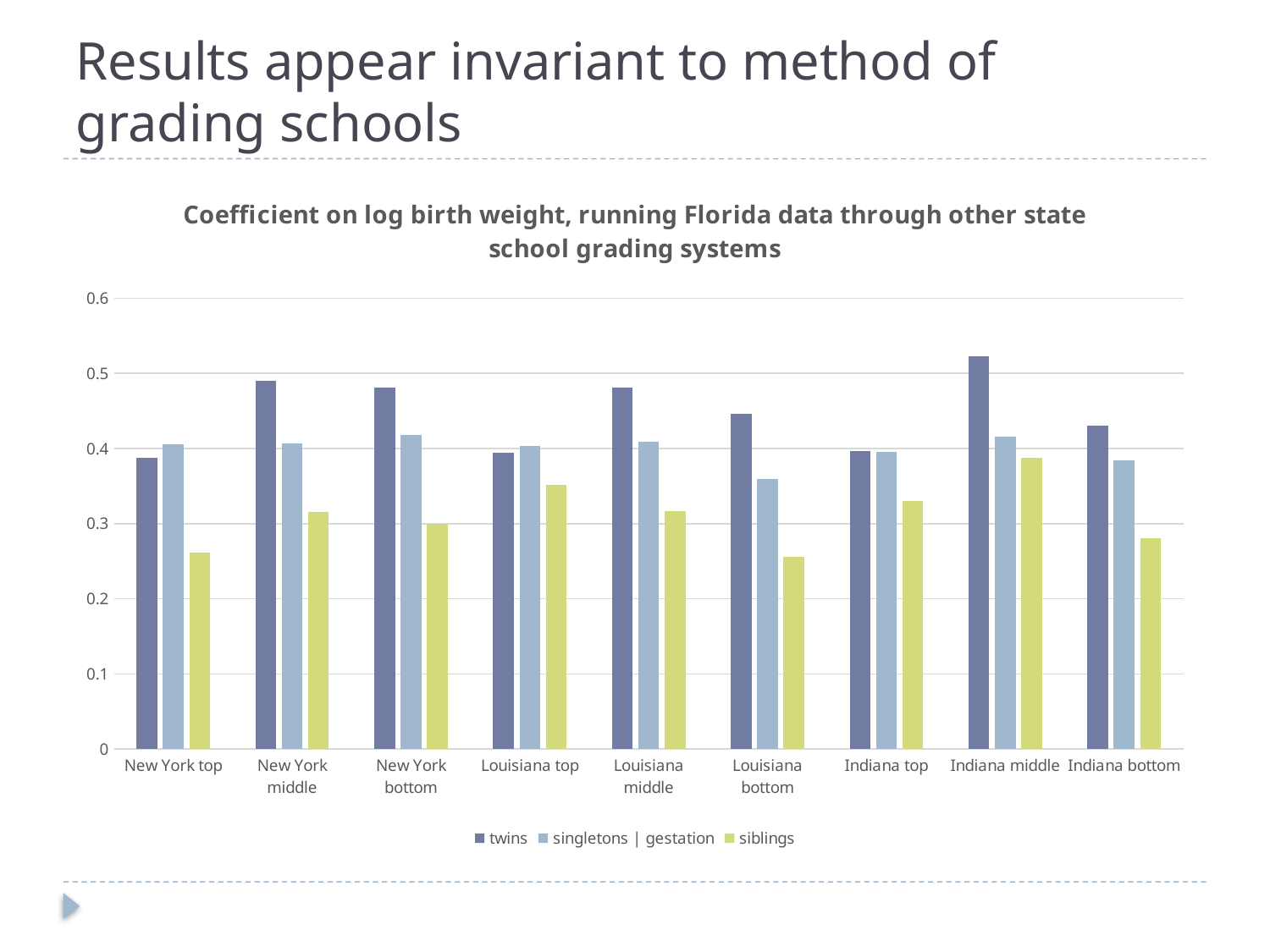
At Indiana bottom, which is larger: the twins value or the siblings value? twins Is the value for siblings at New York top greater or less than 0.3? less Which category has the highest value for the siblings series? Indiana middle Is the value for twins at Louisiana bottom greater or less than 0.4? greater Is the value for singletons | gestation at Louisiana bottom greater or less than 0.4? less At New York bottom, which is larger: the singletons | gestation value or the siblings value? singletons | gestation How many categories are shown along the x axis? 9 Which category has the highest value for the twins series? Indiana middle How many series does the legend list? 3 What is the title of the chart? Coefficient on log birth weight, running Florida data through other state school grading systems What kind of chart is shown on the slide? bar chart